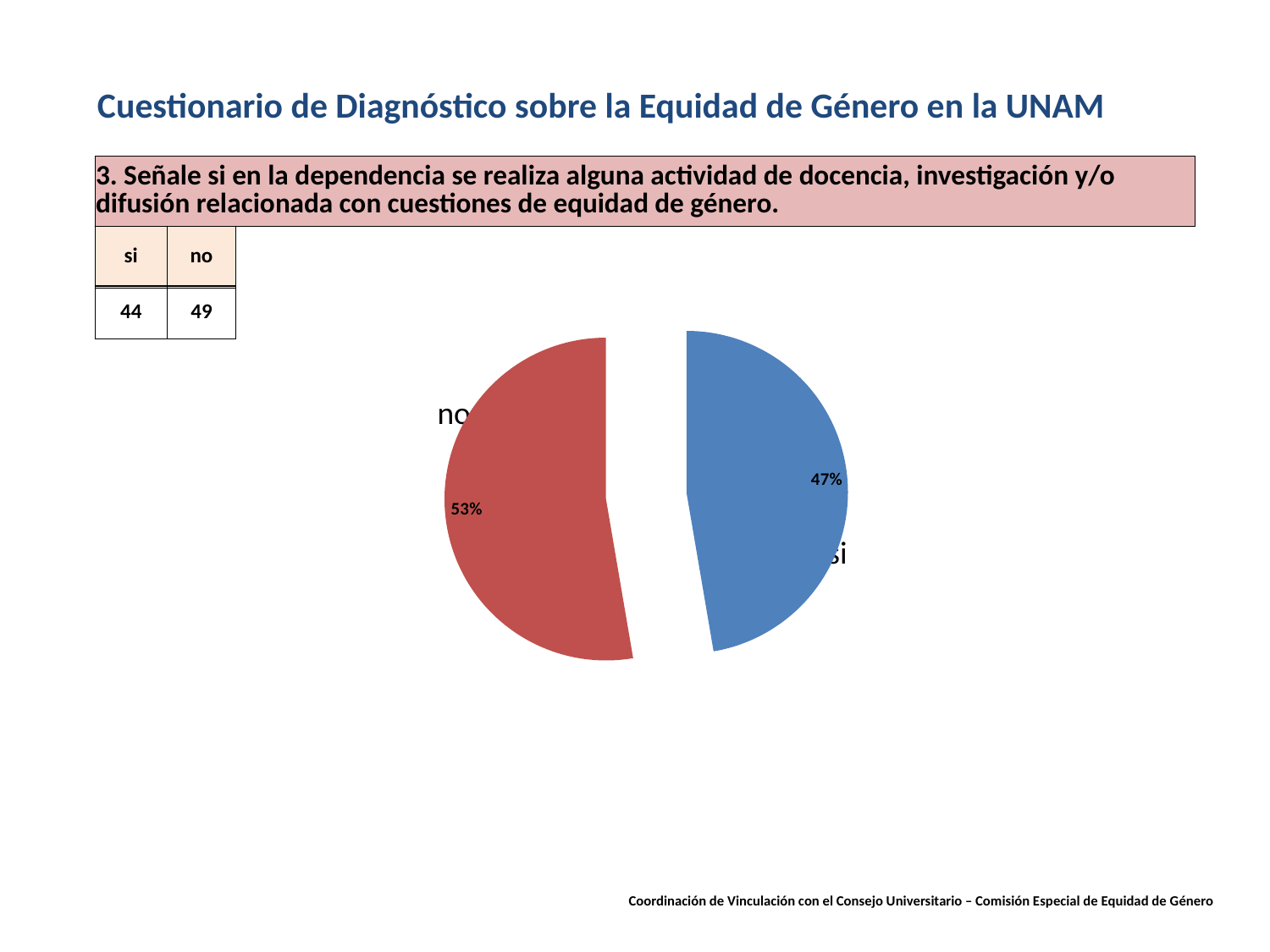
Which slice of the pie chart is the smallest? si What percentage of the pie chart is labelled "no"? 53% How many slices does the pie chart have? 2 Which slice is larger in the pie chart, "si" or "no"? no According to the table on the slide, how many responses were "no"? 49 What is the difference in percentage points between the "no" slice and the "si" slice? 6 According to the table on the slide, how many responses were "si"? 44 What kind of chart is shown on the slide? pie chart Which slice of the pie chart is the largest? no What colour is the "si" slice of the pie chart? blue What percentage of the pie chart is labelled "si"? 47% What colour is the "no" slice of the pie chart? red